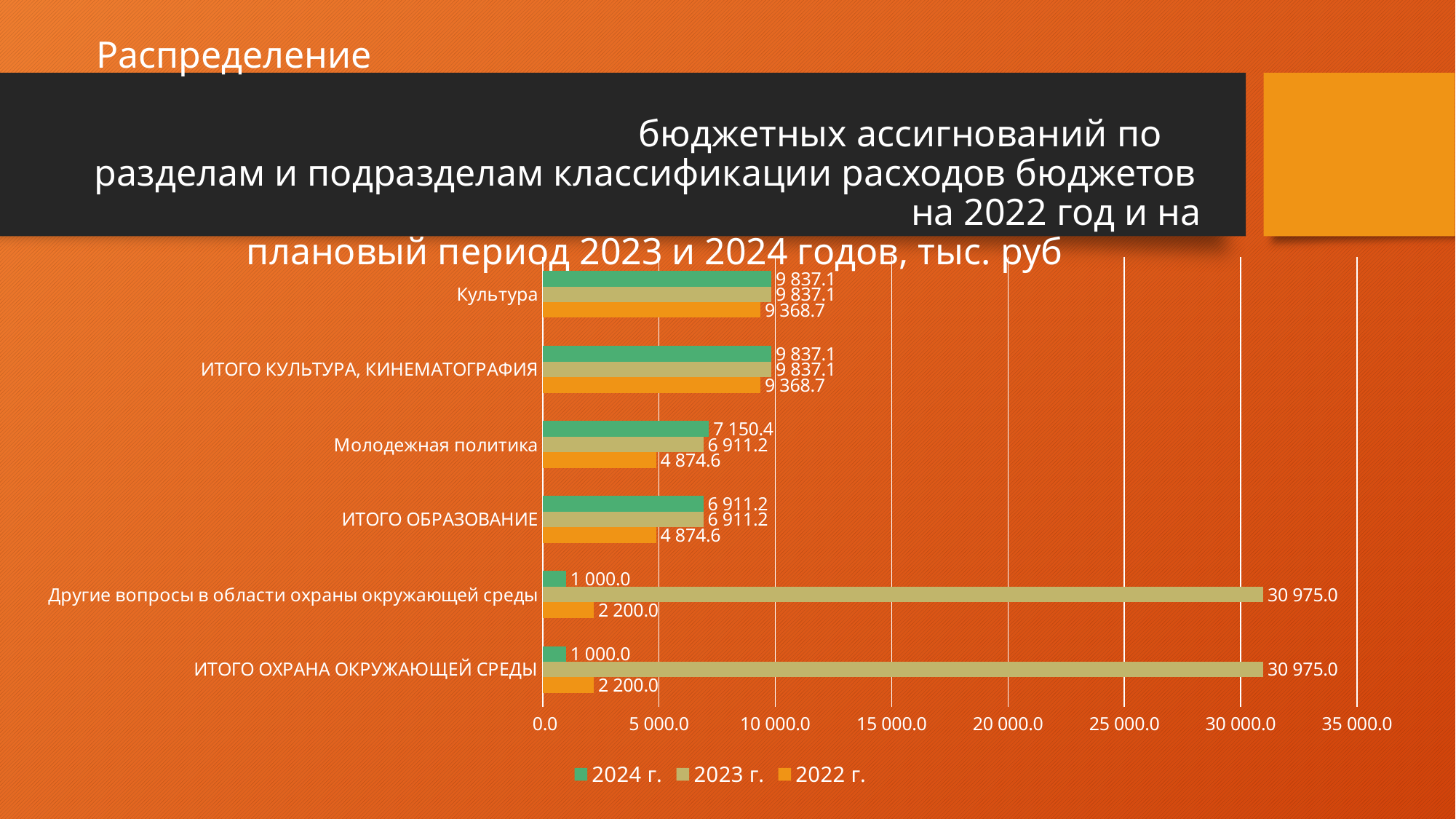
What is the value for Молодежная политика in the 2024 г. series? 7 150.4 For Молодежная политика, which series has the highest value? 2024 г. What is the difference between the 2024 г. and 2022 г. values for Молодежная политика? 2 275.8 What is the difference between the 2023 г. and 2022 г. values for Другие вопросы в области охраны окружающей среды? 28 775.0 What is the value for ИТОГО ОБРАЗОВАНИЕ in the 2022 г. series? 4 874.6 For ИТОГО ОХРАНА ОКРУЖАЮЩЕЙ СРЕДЫ, which series has the lowest value? 2024 г. What is the value for Другие вопросы в области охраны окружающей среды in the 2023 г. series? 30 975.0 How many series does the legend list? 3 Is the 2023 г. value for ИТОГО ОХРАНА ОКРУЖАЮЩЕЙ СРЕДЫ greater or less than 30 000.0? greater How many categories are shown on the chart? 6 What is the value for Культура in the 2022 г. series? 9 368.7 Which is larger for Культура: the 2024 г. value or the 2022 г. value? 2024 г.